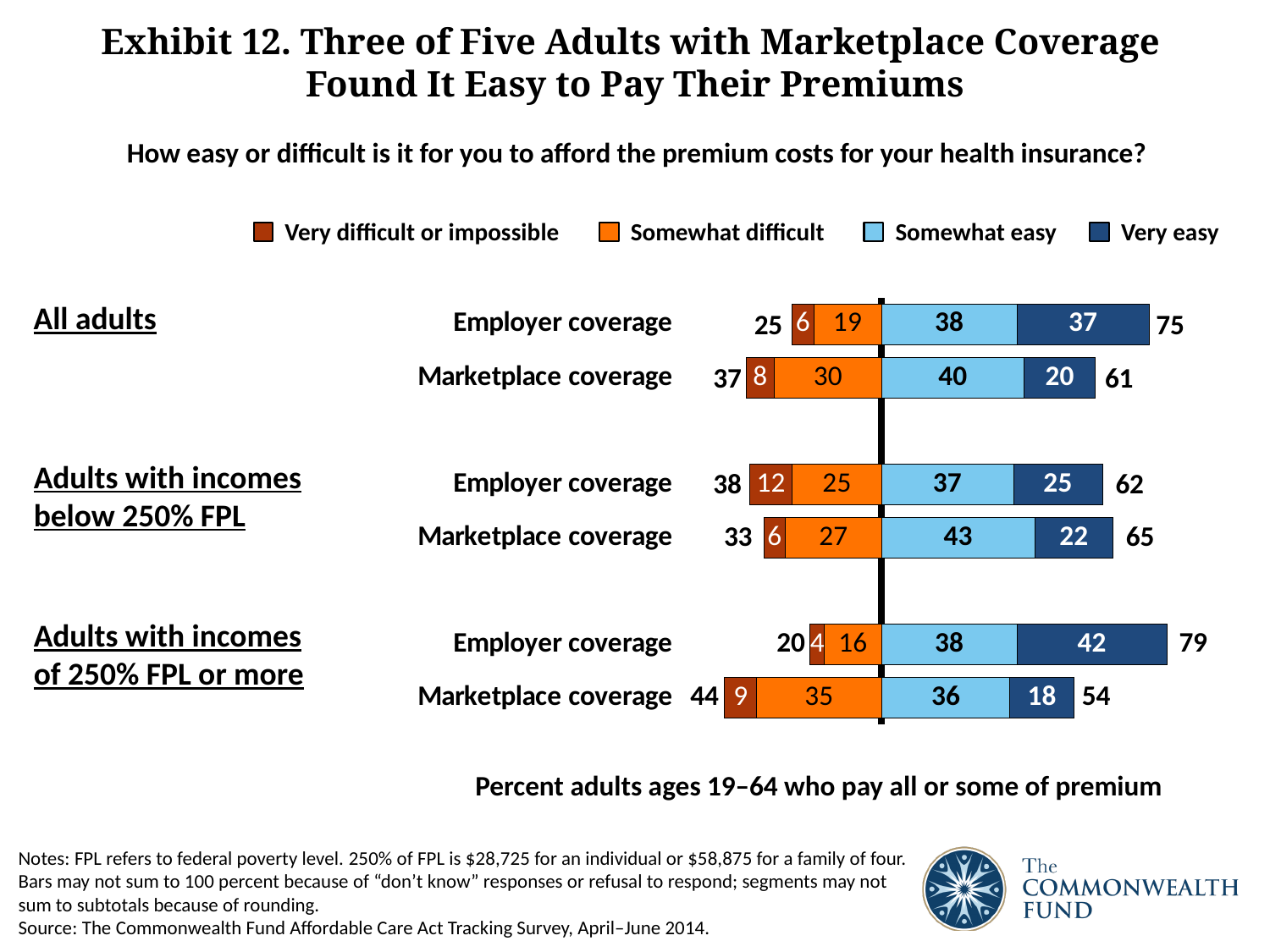
What kind of chart is shown on the slide? Stacked bar chart What is the 'Very difficult or impossible' value for Marketplace coverage among adults with incomes of 250% FPL or more? 9 How many series does the legend list? 4 Which bar has the highest 'Very easy' value? Employer coverage, adults with incomes of 250% FPL or more Among all adults, which has the larger 'Somewhat difficult' value: Employer coverage or Marketplace coverage? Marketplace coverage What is the 'Very easy' value for Marketplace coverage among all adults? 20 Which bar has the lowest 'Very easy' value? Marketplace coverage, adults with incomes of 250% FPL or more What is the 'Somewhat difficult' value for Employer coverage among adults with incomes below 250% FPL? 25 How many bars (coverage groups) are plotted on the chart? 6 What is the difference between the 'Somewhat easy' values for Marketplace coverage and Employer coverage among adults with incomes below 250% FPL? 6 What is the combined 'easy' subtotal shown for Employer coverage among adults with incomes of 250% FPL or more? 79 Which legend entry is shown in the darkest blue colour? Very easy